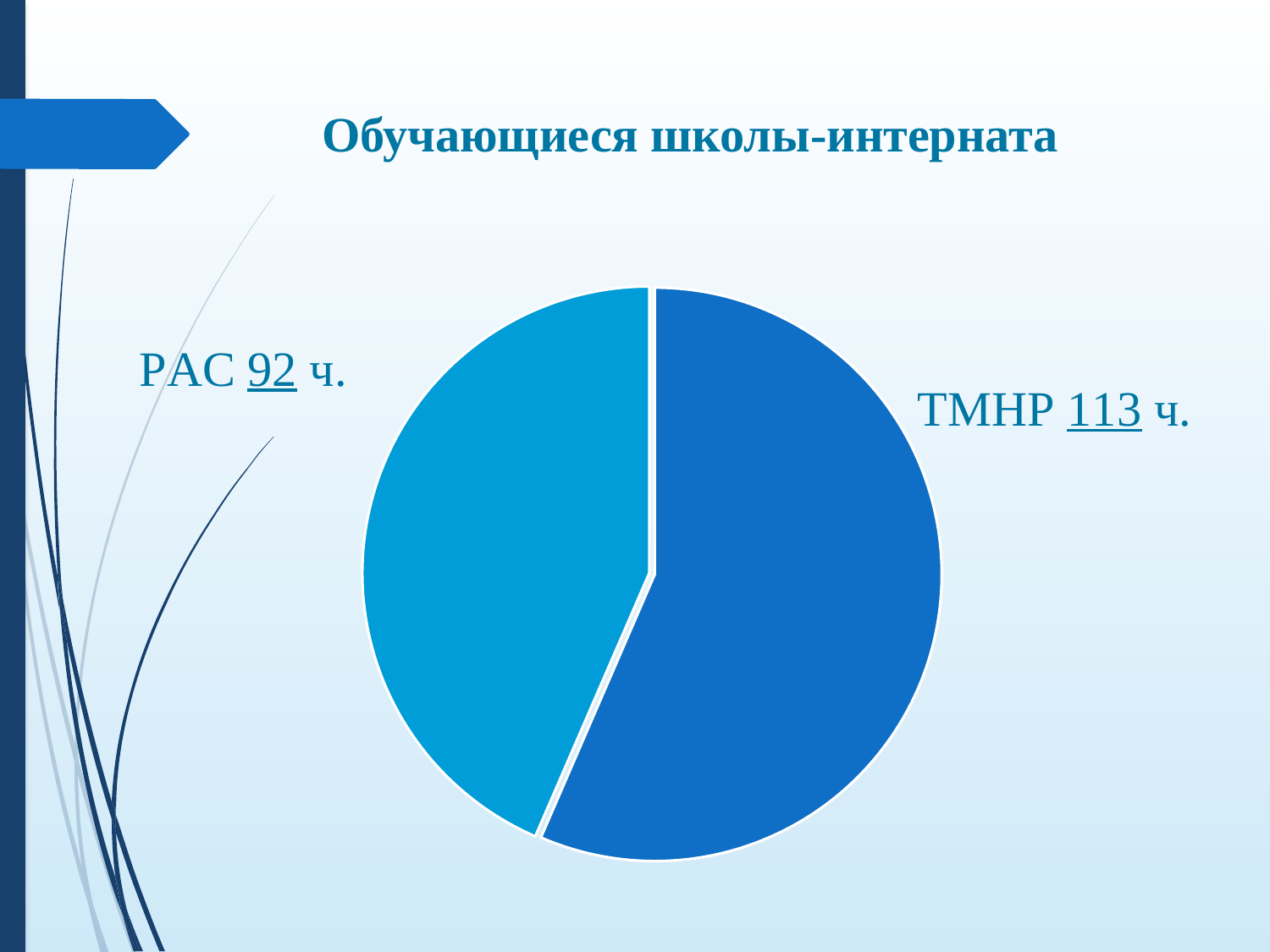
How many slices does the pie chart have? 2 Which is larger, the value for РАС or the value for ТМНР? ТМНР What kind of chart is shown on the slide? pie chart Which category has the smaller slice of the pie? РАС What is the total of the two values shown in the pie chart? 205 ч. What is the title of the chart? Обучающиеся школы-интерната What share of the pie does ТМНР represent, to the nearest whole percent? 55% What is the difference between the values for ТМНР and РАС? 21 ч. Which slice is drawn in the lighter blue colour? РАС What is the value shown for РАС? 92 ч. Which category has the larger slice of the pie? ТМНР What is the value shown for ТМНР? 113 ч.